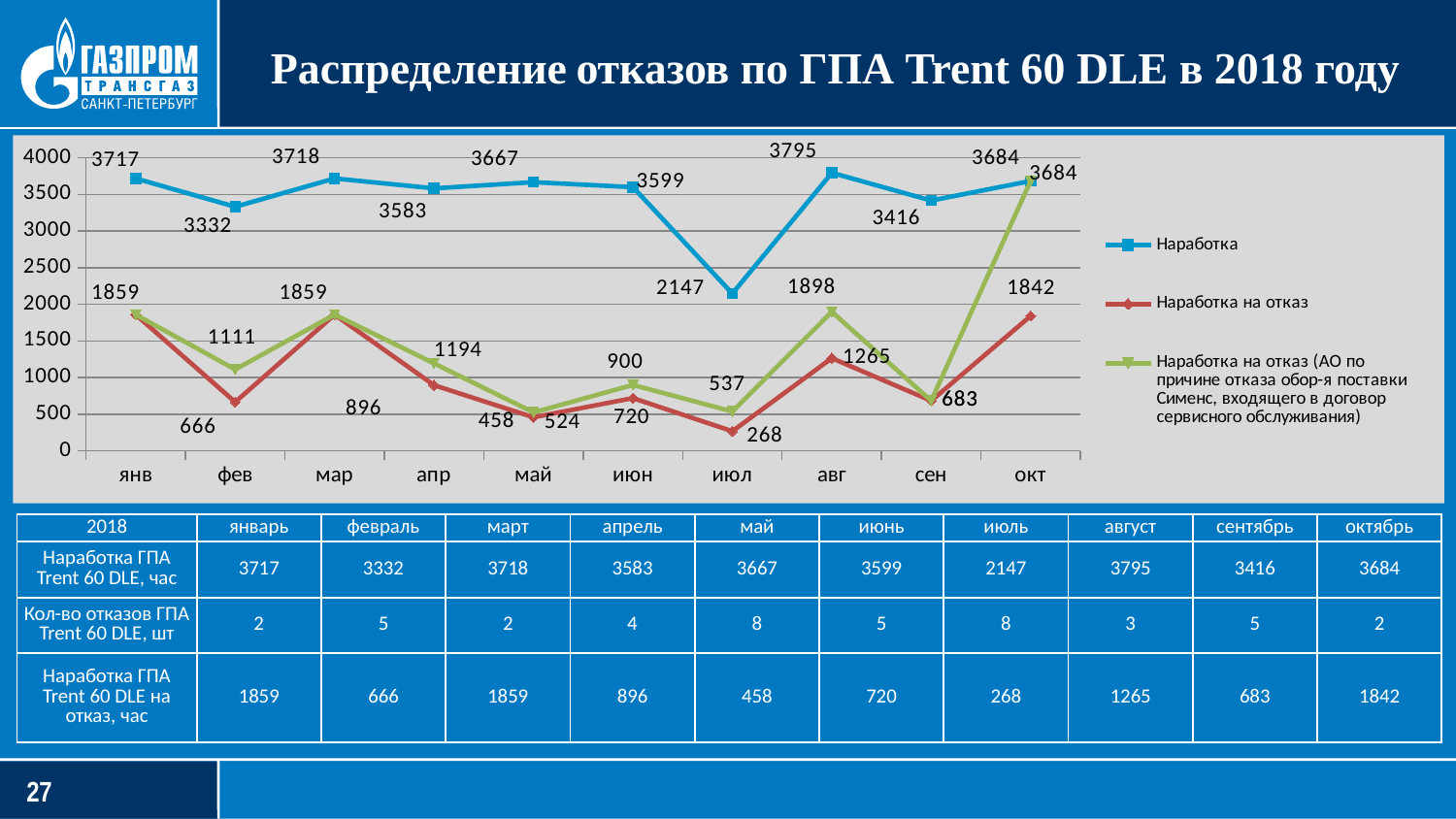
How many months are plotted along the x axis of the chart? 10 In which month is the Наработка на отказ series at its lowest? июл Is the Наработка value for июл greater or less than 2500? less What is the difference between the Наработка values for янв and фев? 385 Which is larger: the Наработка на отказ value for авг or for сен? авг What kind of chart is shown on the slide? line chart What colour is the line for the Наработка series? blue What is the value of the Наработка на отказ series for май? 458 What is the value of the Наработка series for июл? 2147 In which month is the Наработка series at its highest? авг How many series does the chart legend list? 3 Does the Наработка на отказ series rise or fall from сен to окт? rise